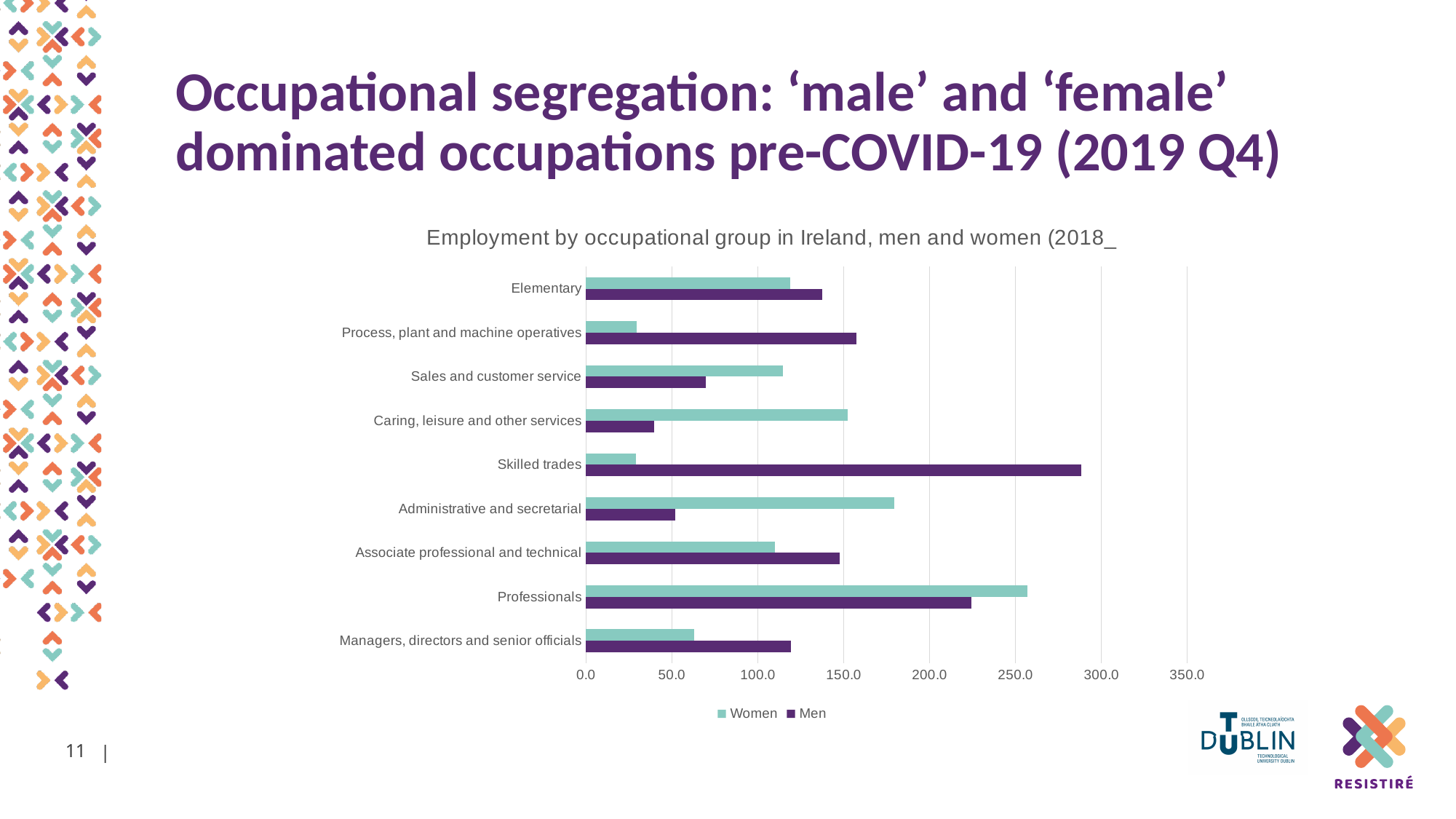
Is the value for Women in Administrative and secretarial greater or less than 150.0? greater Is the value for Men in Skilled trades greater or less than 250.0? greater What kind of chart is shown on the slide? bar chart Which occupational group has the highest value for Women? Professionals For Professionals, which is larger, the value for Women or the value for Men? Women Which occupational group has the highest value for Men? Skilled trades Is the value for Men in Managers, directors and senior officials greater or less than 100.0? greater For Skilled trades, which is larger, the value for Women or the value for Men? Men How many occupational groups are plotted on the chart? 9 Which two series are listed in the chart legend? Women and Men How many series does the legend list? 2